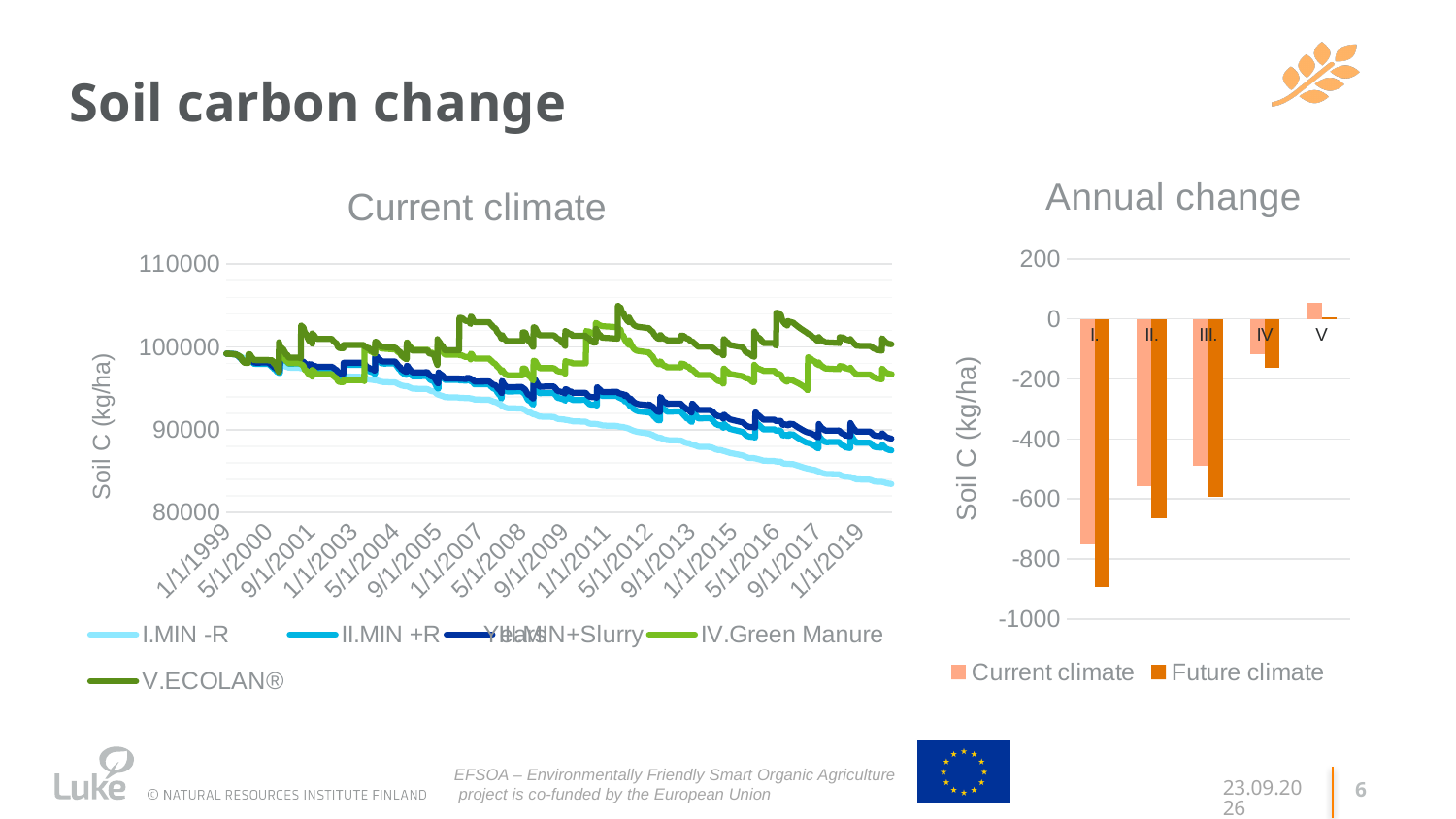
What kind of chart is the "Annual change" chart on the right? bar chart How many series does the legend of the "Current climate" chart list? 5 In the "Annual change" chart, which category has the highest Current climate value? V How many series does the legend of the "Annual change" chart list? 2 In the "Annual change" chart, is the Future climate value for category I. greater or less than -800? less What kind of chart is the "Current climate" chart on the left? line chart In the "Current climate" chart, which series has the lowest value at 1/1/2019? I.MIN -R In the "Current climate" chart, does the I.MIN -R series rise or fall from 1999 to 2019? fall In the "Annual change" chart, which category has the lowest Future climate value? I. How many categories are shown on the x axis of the "Annual change" chart? 5 In the "Annual change" chart, which is larger, the Future climate value for I. or for IV? IV What is the y-axis label of the "Annual change" chart? Soil C (kg/ha)